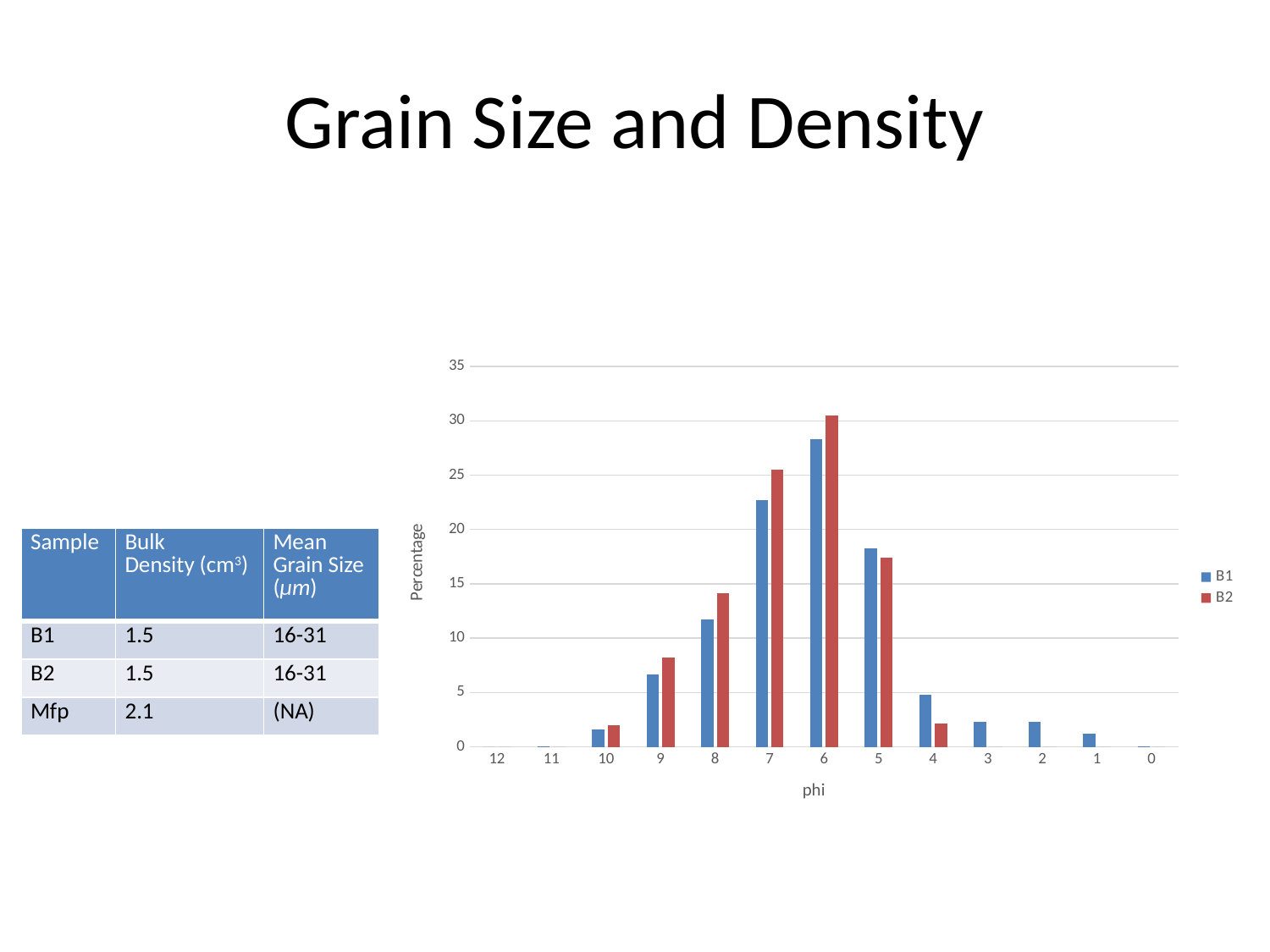
What is the label on the vertical axis of the chart? Percentage Is the value for B2 at phi 8 greater or less than 15? less Is the value for B1 at phi 7 greater or less than 20? greater At phi 4, which series has the larger value, B1 or B2? B1 How many series does the chart legend list? 2 At which phi value does series B2 reach its highest percentage? 6 How many phi categories are shown on the x axis of the chart? 13 Is the value for B1 at phi 6 greater or less than 25? greater At phi 6, which series has the larger value, B1 or B2? B2 Do the B1 values rise or fall going from phi 9 to phi 6? rise What kind of chart is shown on the slide? bar chart At which phi value does series B1 reach its highest percentage? 6